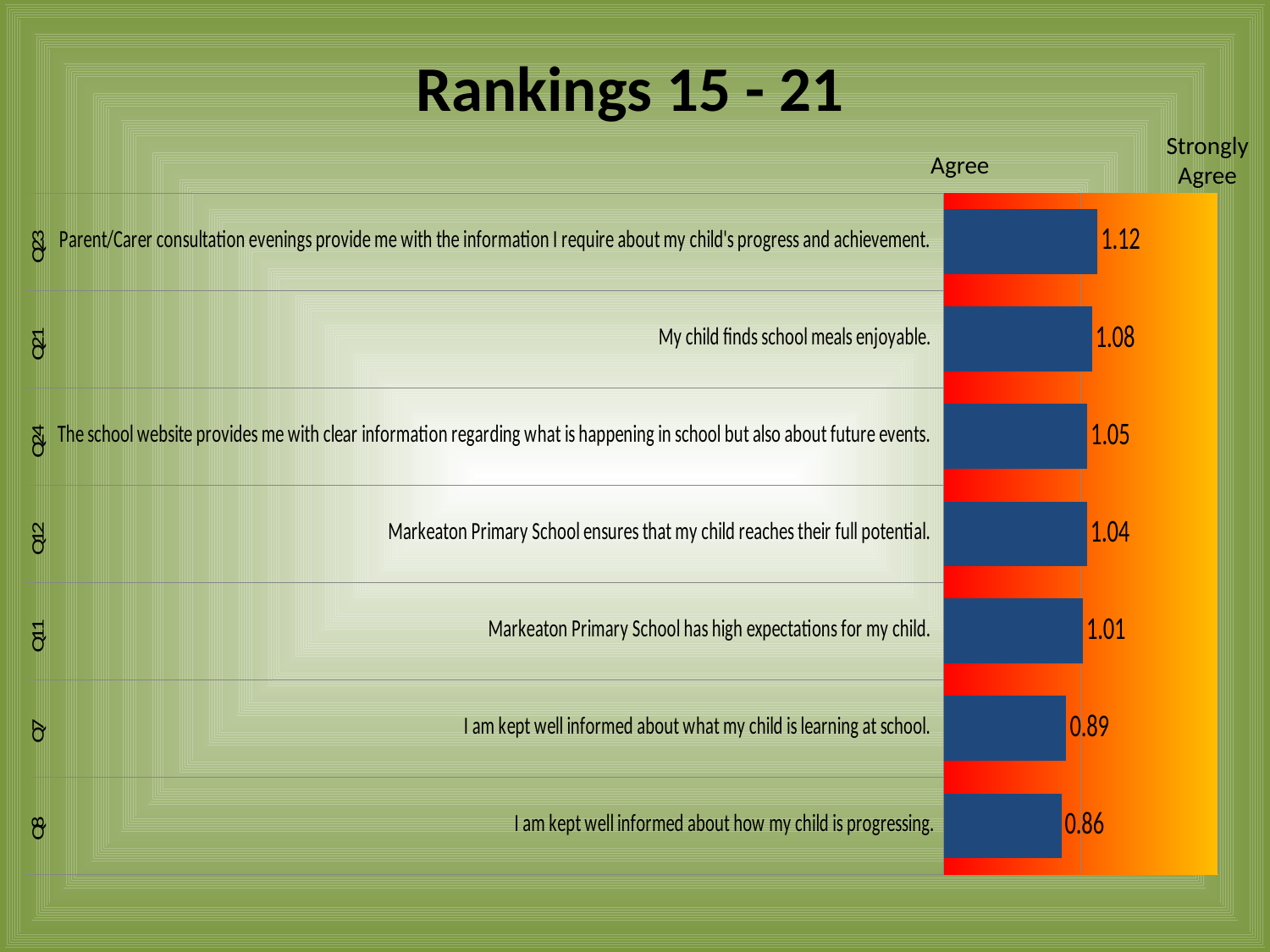
What is the value for "Markeaton Primary School has high expectations for my child."? 1.01 Which statement has the lowest value? I am kept well informed about how my child is progressing. What is the title of the slide? Rankings 15 - 21 What is the value for "My child finds school meals enjoyable."? 1.08 What is the difference between the values for "My child finds school meals enjoyable." and "I am kept well informed about what my child is learning at school."? 0.19 How many statements (bars) are shown in the chart? 7 Which statement has the highest value? Parent/Carer consultation evenings provide me with the information I require about my child's progress and achievement. What type of chart is shown on the slide? Bar chart What is the value for the statement about the school website providing clear information? 1.05 Which has a larger value: "Markeaton Primary School ensures that my child reaches their full potential." or "I am kept well informed about what my child is learning at school."? Markeaton Primary School ensures that my child reaches their full potential. What is the value for "I am kept well informed about how my child is progressing."? 0.86 What is the difference between the highest value (1.12) and the lowest value (0.86)? 0.26